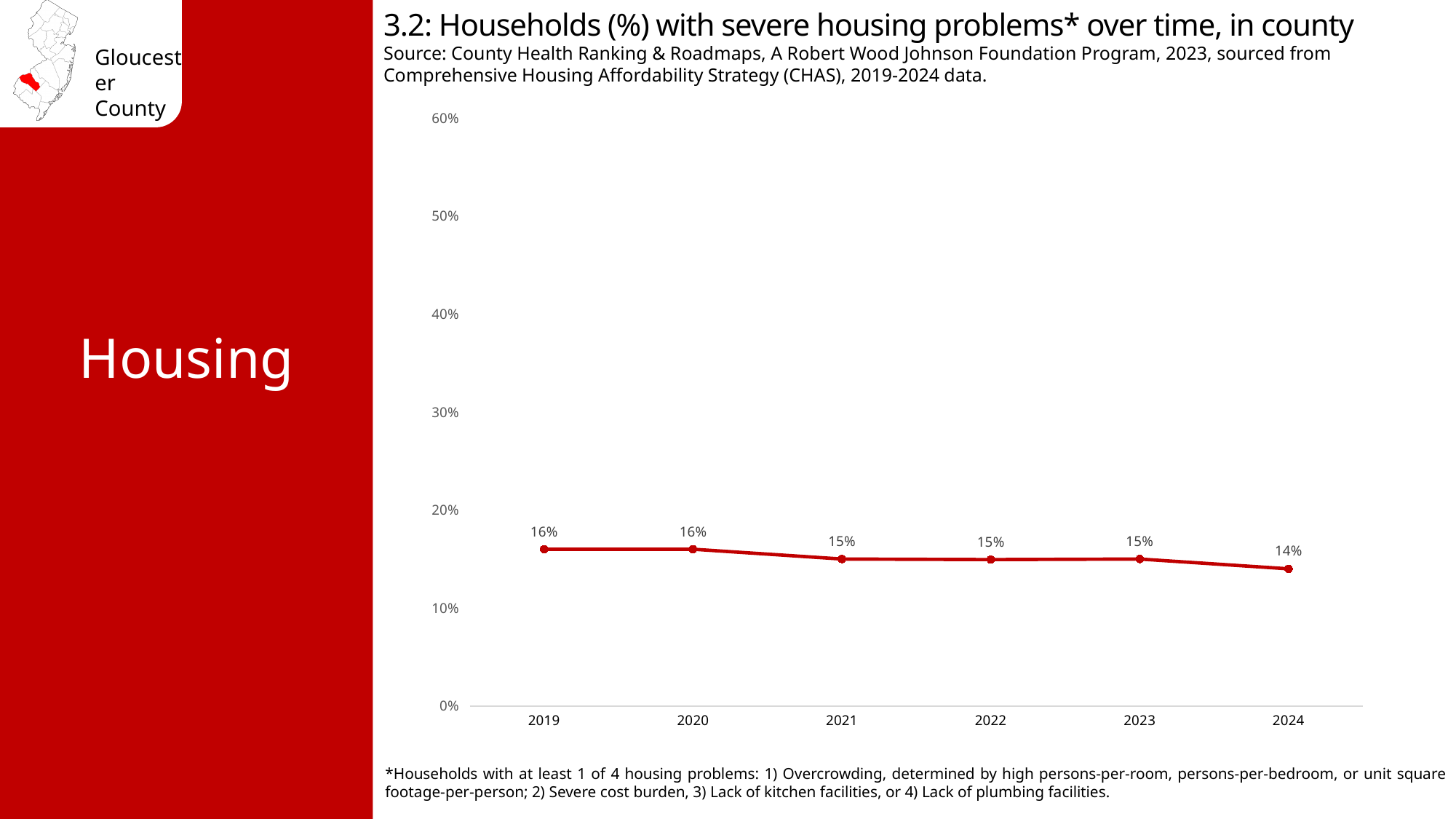
Which year has the lowest percentage of households with severe housing problems? 2024 Do the values rise or fall from 2019 to 2024? fall What percentage of households had severe housing problems in 2019? 16% What colour is the plotted line? red How many years are plotted on the x axis? 6 What is the value shown for 2022? 15% Is the value for 2020 larger or smaller than the value for 2024? larger What is the value shown for 2024? 14% What kind of chart is shown on the slide? line chart What is the highest value shown on the y axis? 60% What is the difference between the 2019 value and the 2024 value? 2% Is the value for 2021 greater or less than 20%? less